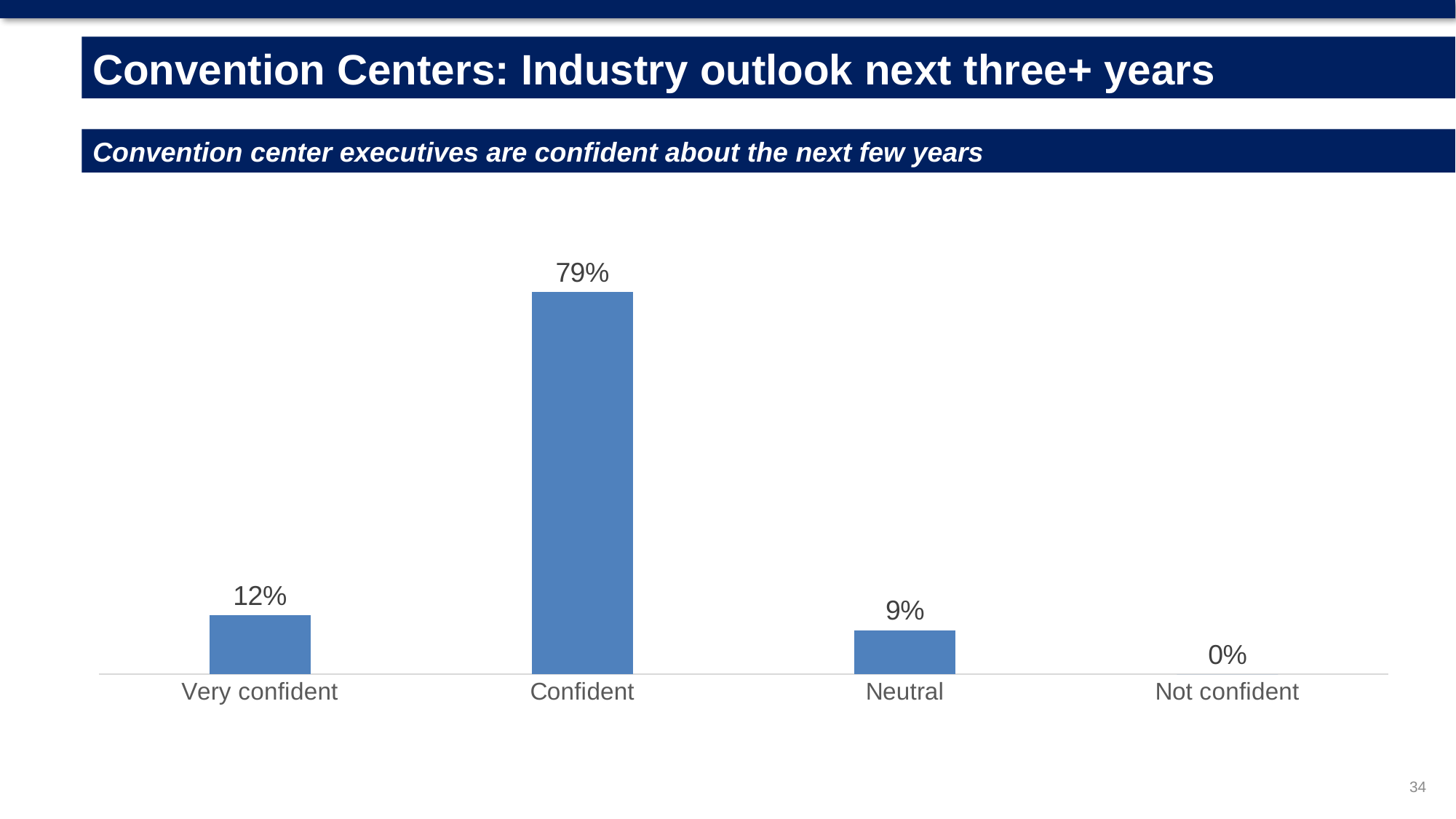
What is the title of the slide containing the chart? Convention Centers: Industry outlook next three+ years Which category has the lowest value? Not confident What kind of chart is shown on the slide? Bar chart What is the difference between the values for Very confident and Neutral? 3% What is the value for Very confident? 12% How many categories are shown on the x axis? 4 What is the value for Neutral? 9% Which category has the highest value? Confident What is the value for Not confident? 0% What is the value for Confident? 79% What is the difference between the values for Confident and Very confident? 67% Which is larger, the value for Very confident or the value for Neutral? Very confident